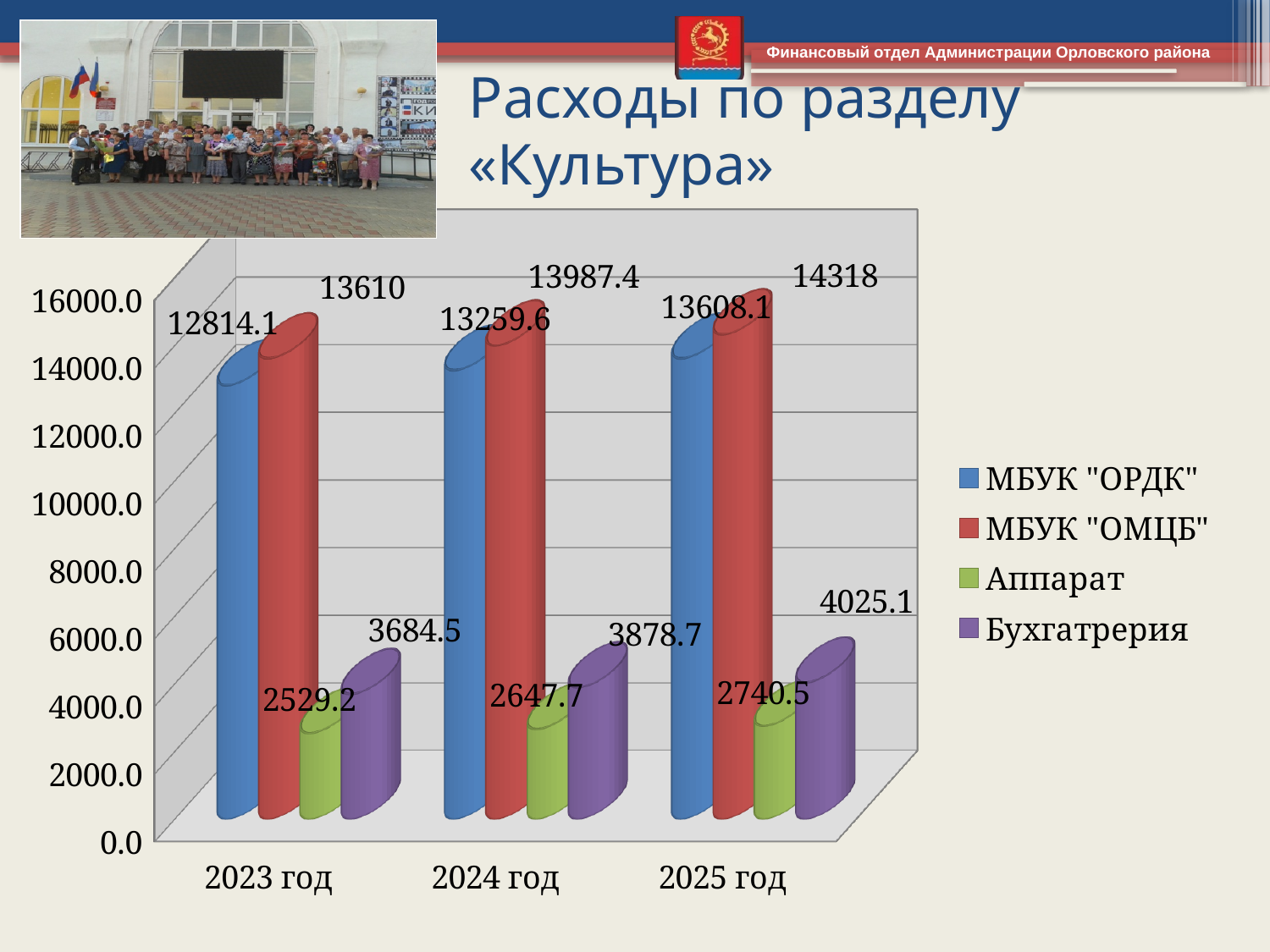
What is the value for МБУК "ОМЦБ" in 2025 год? 14318 Which series has the highest value in 2024 год? МБУК "ОМЦБ" How many series does the legend list? 4 Which is larger: Бухгатрерия in 2023 год or Аппарат in 2025 год? Бухгатрерия in 2023 год Which series has the lowest value in 2023 год? Аппарат What is the value for Аппарат in 2024 год? 2647.7 What is the difference between the МБУК "ОМЦБ" and МБУК "ОРДК" values in 2024 год? 727.8 What is the value for МБУК "ОРДК" in 2023 год? 12814.1 How many year categories are shown on the x axis? 3 What is the value for Бухгатрерия in 2025 год? 4025.1 Does the value for МБУК "ОРДК" rise or fall from 2023 год to 2025 год? rise What kind of chart is shown on the slide? bar chart